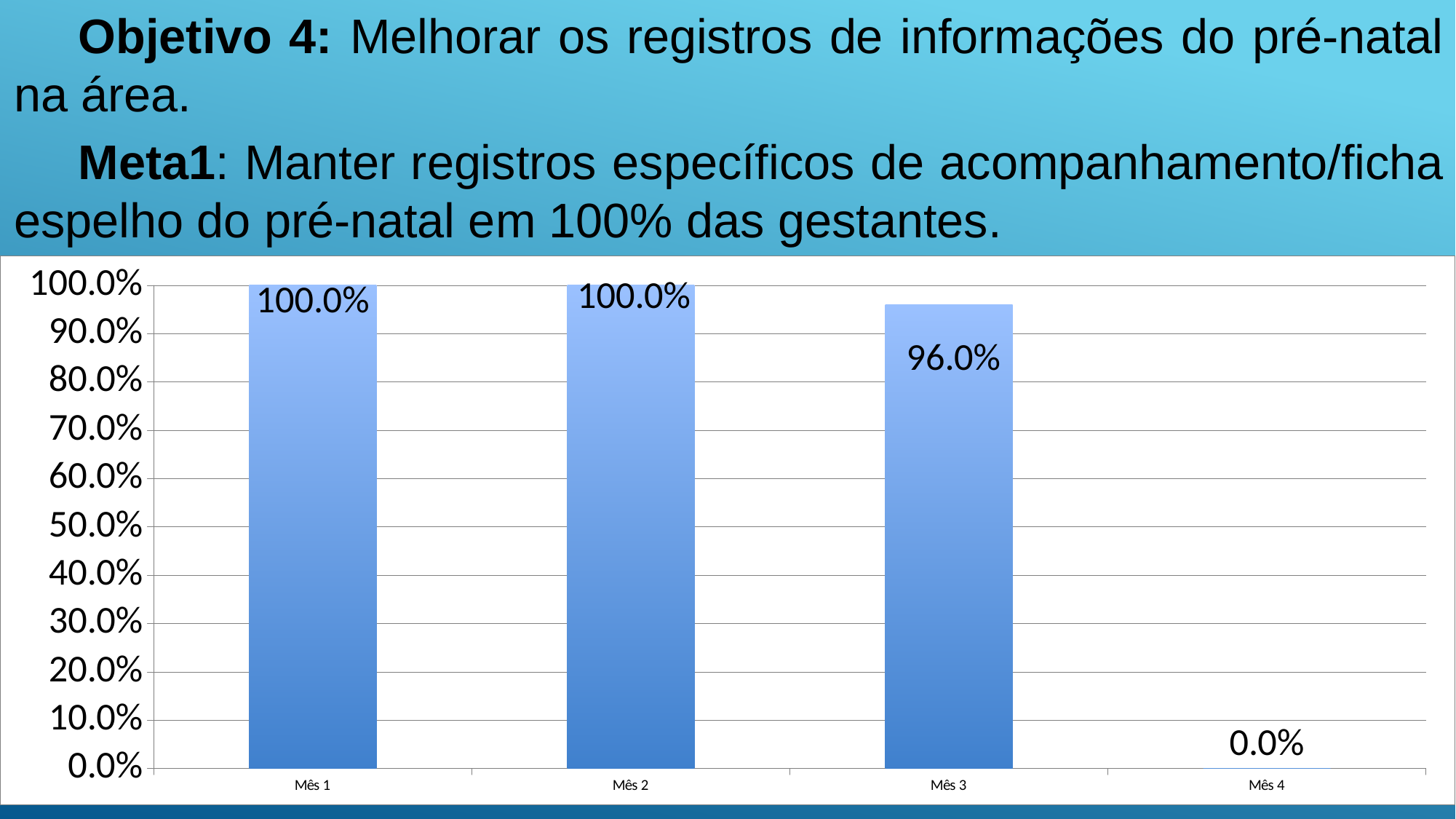
What is the difference between the values for Mês 2 and Mês 3? 4.0% What is the value for Mês 4? 0.0% What is the highest value shown on the y axis? 100.0% Is the value for Mês 3 greater or less than 90.0%? greater What kind of chart is shown on the slide? bar chart Do the values rise or fall from Mês 2 to Mês 4? fall What is the value for Mês 1? 100.0% Which month has the lowest value? Mês 4 What is the value for Mês 3? 96.0% How many months are shown on the x axis? 4 Which is larger, the value for Mês 1 or the value for Mês 3? Mês 1 What is the value for Mês 2? 100.0%